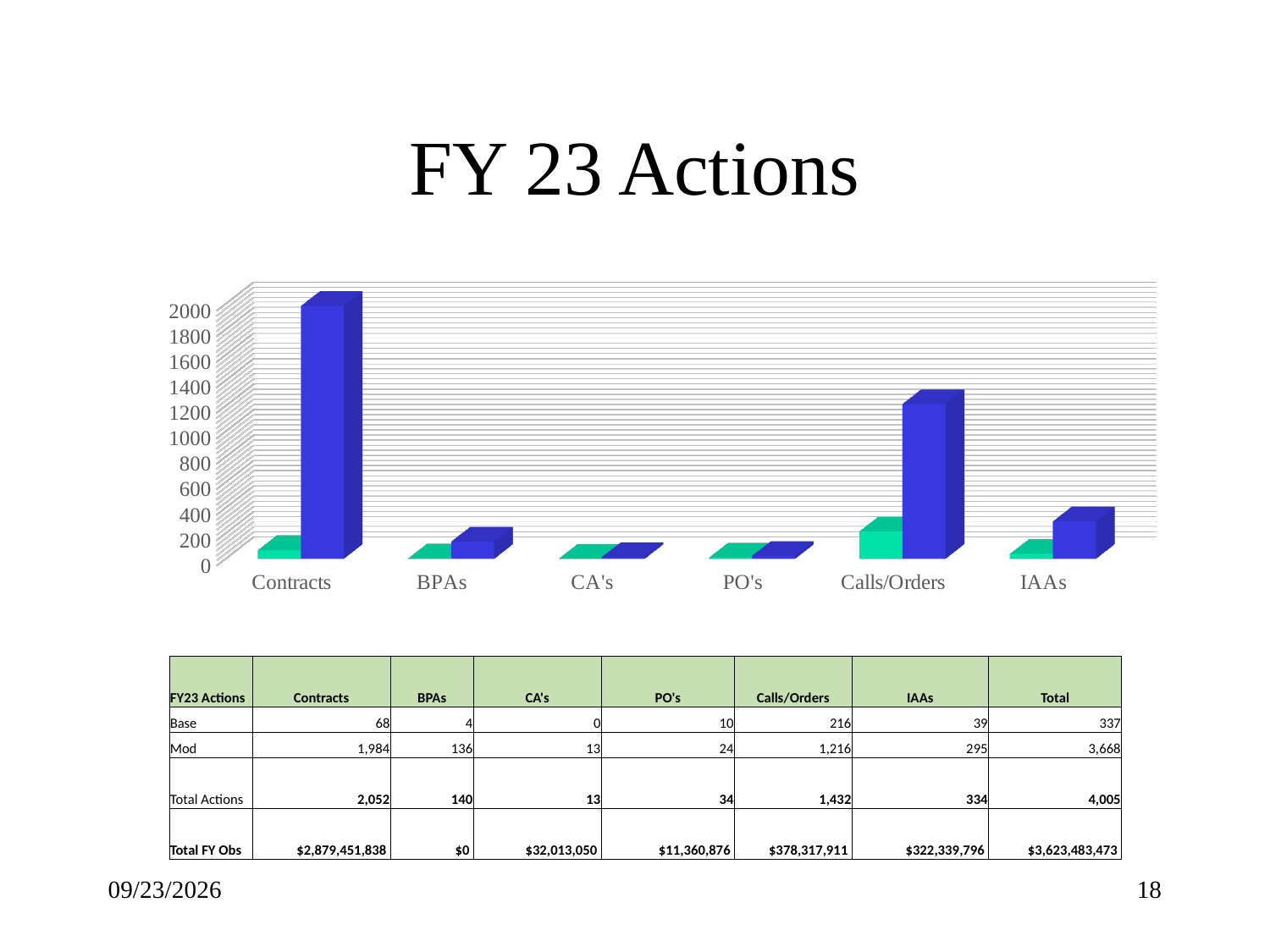
Which category has the tallest bar in the chart? Contracts Is the value of the blue bar for Calls/Orders greater or less than 1000? greater According to the table below the chart, what is the Mod value for Contracts? 1,984 How many categories are shown along the x axis of the chart? 6 Is the value of the blue bar for IAAs greater or less than 400? less What kind of chart is shown on the slide? bar chart What is the title of the slide containing the chart? FY 23 Actions According to the table, what is the Total Actions value for BPAs? 140 According to the table below the chart, what is the Base value for Calls/Orders? 216 Which has a taller blue bar, Calls/Orders or IAAs? Calls/Orders Is the value of the tall blue bar for Contracts greater or less than 1800? greater Which category has the shortest bars in the chart? CA's